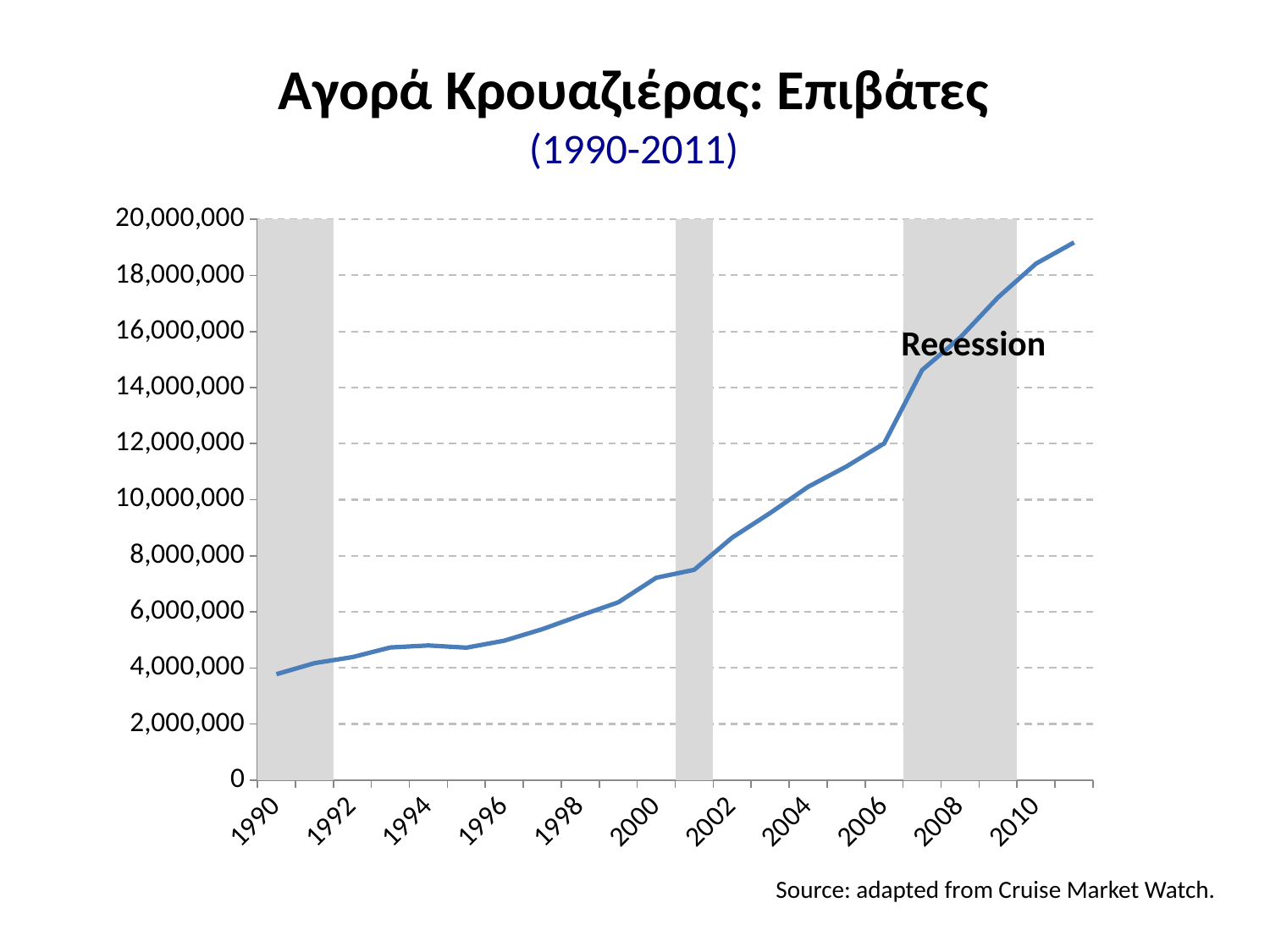
Which year has the highest value on the chart? 2011 What do the grey shaded bands on the chart represent? Recession Is the value for 2011 greater or less than 18,000,000? greater What is the title of the chart? Αγορά Κρουαζιέρας: Επιβάτες (1990-2011) Which year has the lowest value on the chart? 1990 What kind of chart is shown on the slide? line chart Do the values generally rise or fall from 1990 to 2011? rise Is the value for 2006 greater or less than 14,000,000? less Which year has the larger value, 2002 or 2008? 2008 Is the value for 2000 greater or less than 6,000,000? greater